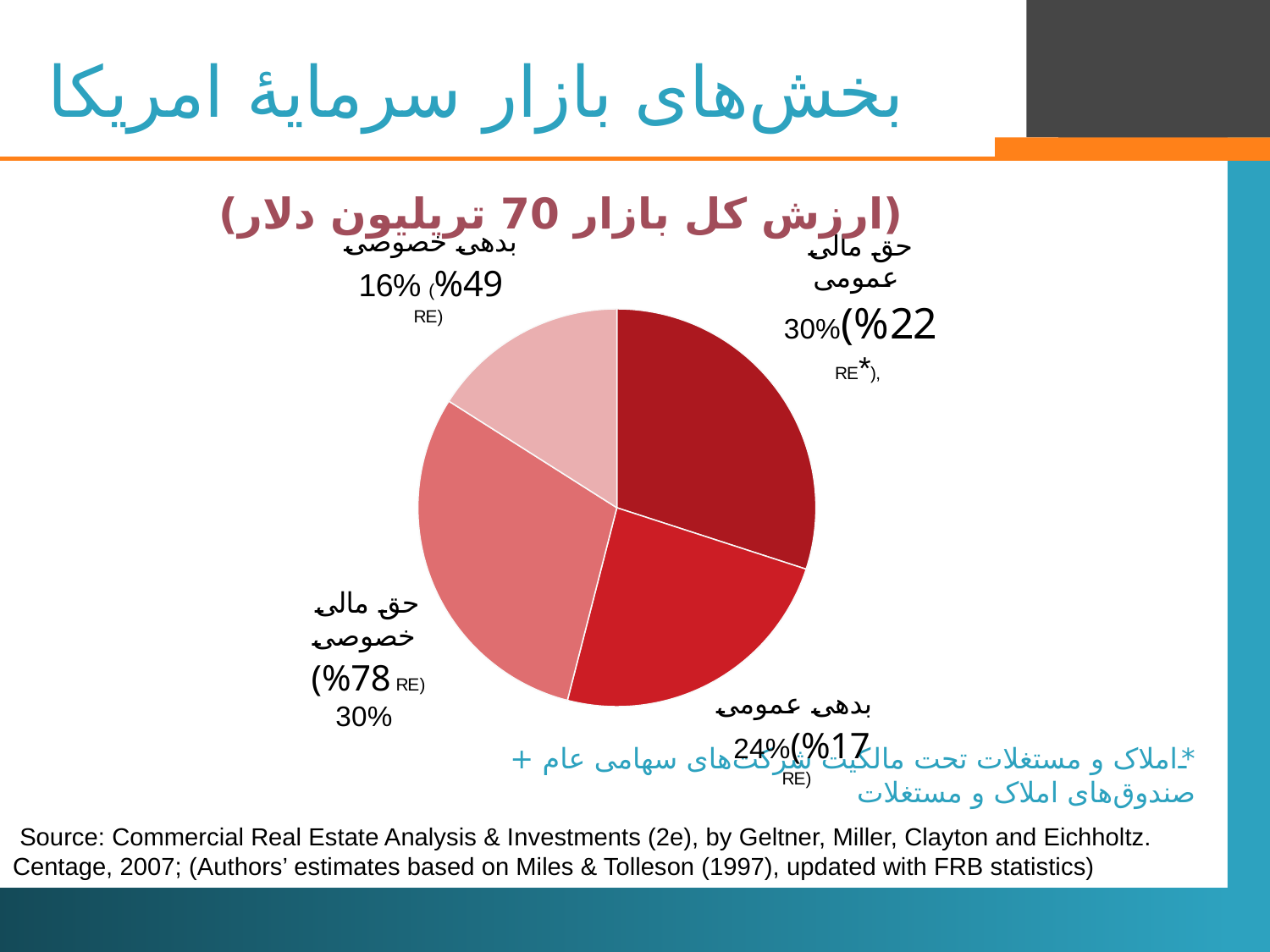
What share of the pie does بدهی خصوصی (private debt) represent? 16% According to the chart title, what is the total market value? 70 تریلیون دلار (70 trillion dollars) What is the title of the slide? بخش‌های بازار سرمایۀ امریکا What type of chart is shown on the slide? Pie chart What is the difference in percentage points between the share for حق مالی عمومی (public equity) and the share for بدهی عمومی (public debt)? 6 percentage points What share of the pie does حق مالی خصوصی (private equity) represent? 30% Which slice of the pie chart is the smallest? بدهی خصوصی (private debt) What share of the pie does بدهی عمومی (public debt) represent? 24% What is the difference in percentage points between the share for بدهی عمومی (public debt) and the share for بدهی خصوصی (private debt)? 8 percentage points How many slices does the pie chart have? 4 Which is larger: the share for بدهی عمومی (public debt) or the share for بدهی خصوصی (private debt)? بدهی عمومی (public debt)